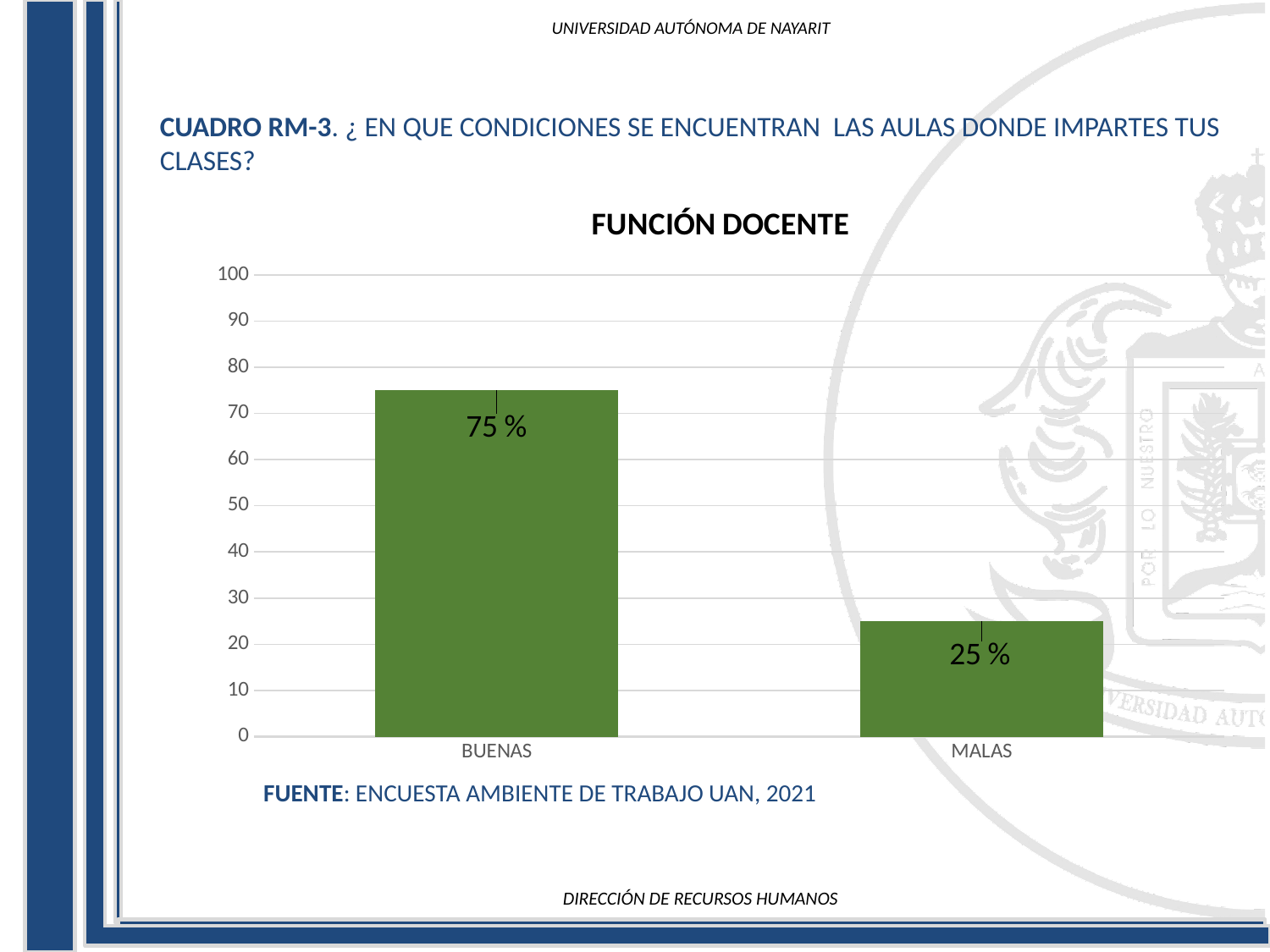
Which category has the lowest value? MALAS Which is larger, the value for BUENAS or the value for MALAS? BUENAS What is the value for BUENAS? 75 % What is the difference between the values for BUENAS and MALAS? 50 % Which category has the highest value? BUENAS How many categories are shown on the x axis? 2 What is the value for MALAS? 25 % What kind of chart is shown on the slide? bar chart Is the value for MALAS greater or less than 30? less What is the title of the chart? FUNCIÓN DOCENTE What is the highest value shown on the y axis? 100 Is the value for BUENAS greater or less than 70? greater